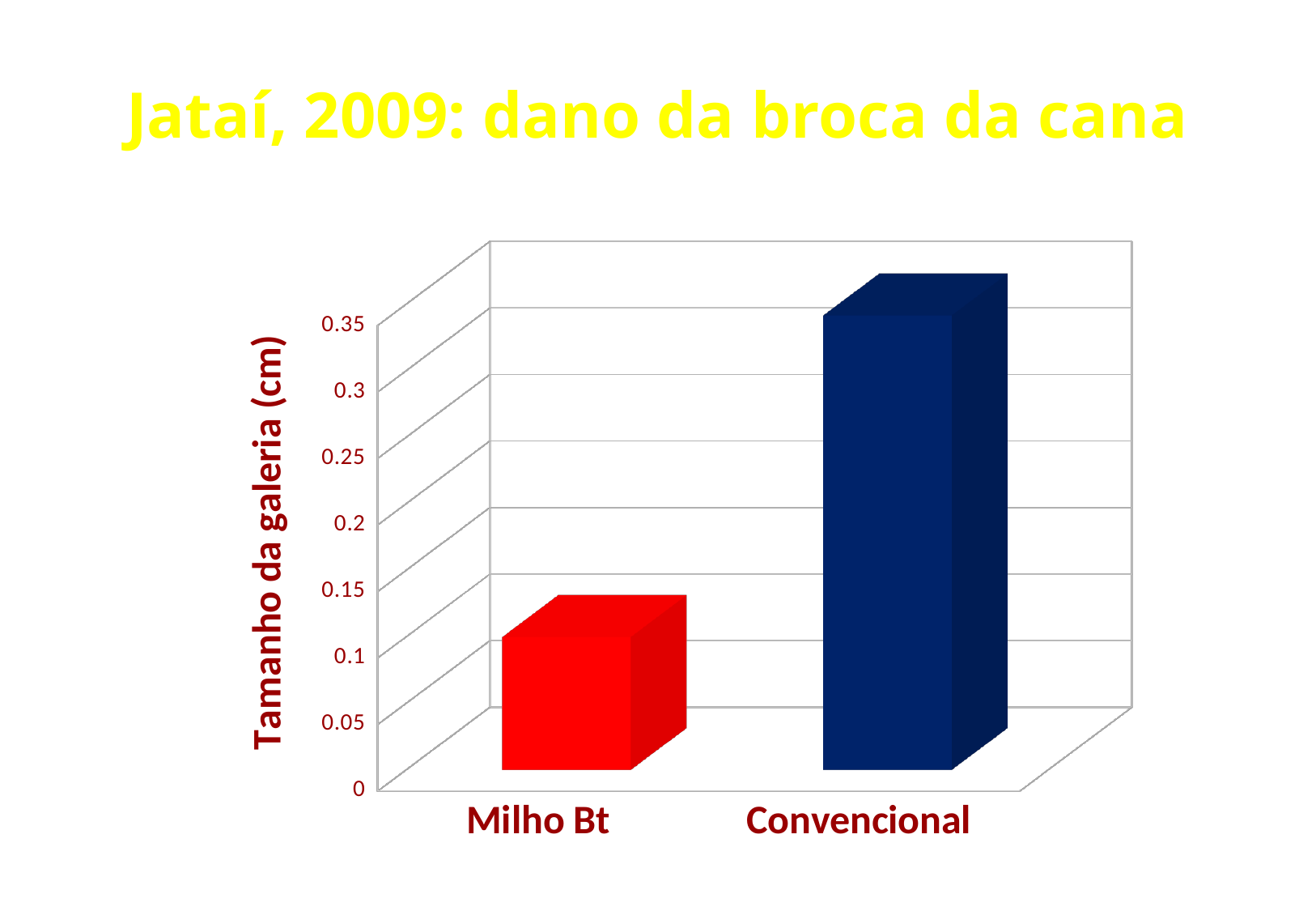
Is the value for Convencional greater or less than 0.3? greater What kind of chart is shown on the slide? bar chart Is the value for Convencional greater or less than 0.25? greater Which category has the highest value? Convencional Is the value for Milho Bt greater or less than 0.2? less Which category has the lowest value? Milho Bt What is the label of the vertical axis? Tamanho da galeria (cm) What is the title of the slide? Jataí, 2009: dano da broca da cana Which is larger, the value for Milho Bt or the value for Convencional? Convencional How many categories are plotted in the chart? 2